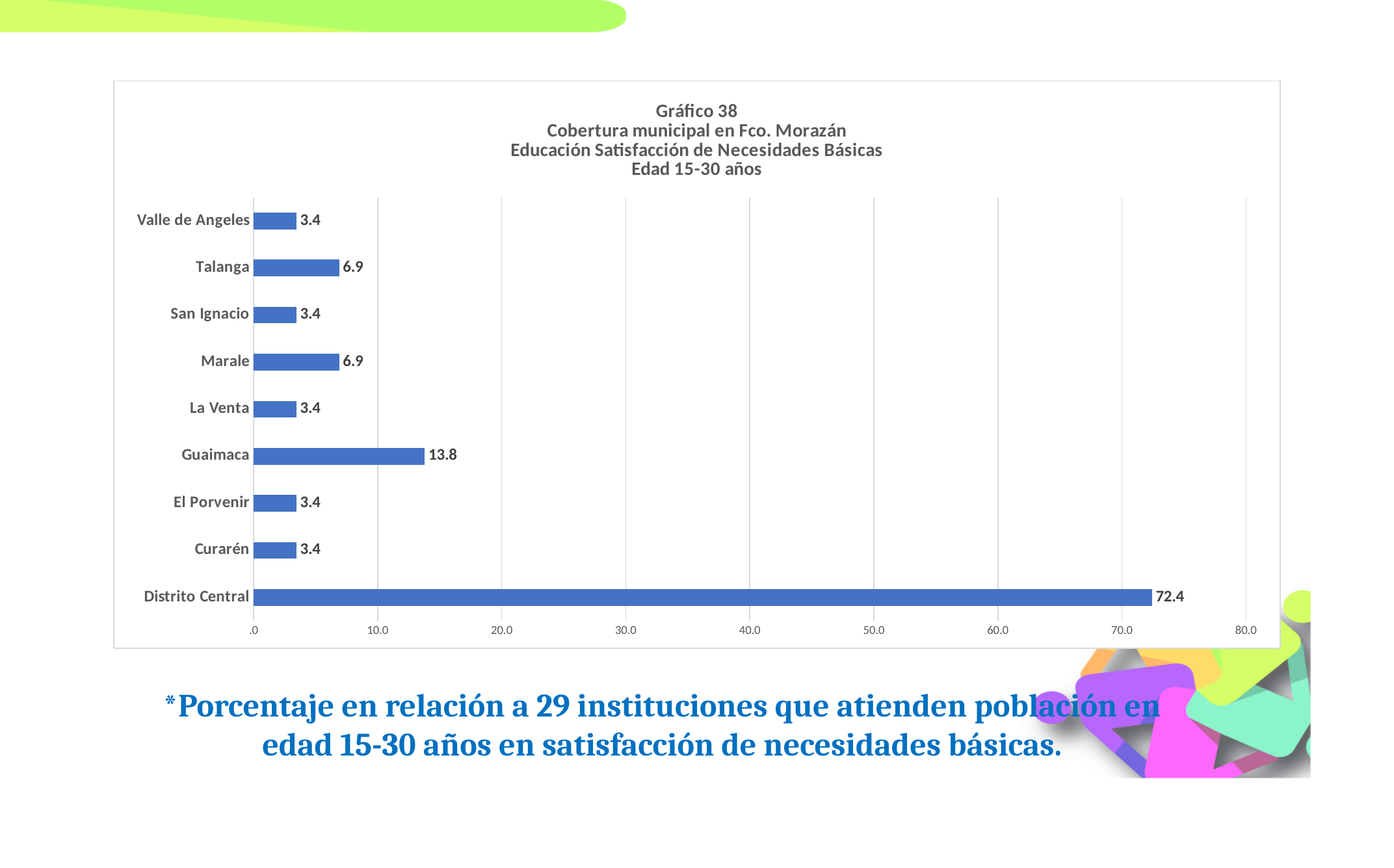
How many categories are shown in the chart? 9 Which category has the highest value? Distrito Central Which is larger, the value for Guaimaca or the value for Talanga? Guaimaca What is the value for Guaimaca? 13.8 What is the value for Distrito Central? 72.4 What is the difference between the values for Distrito Central and Guaimaca? 58.6 What is the number of the chart given in its title? Gráfico 38 Is the value for Distrito Central greater or less than 70.0? greater What is the value for Talanga? 6.9 What is the difference between the values for Marale and La Venta? 3.5 What is the value for Valle de Angeles? 3.4 What kind of chart is shown on the slide? bar chart